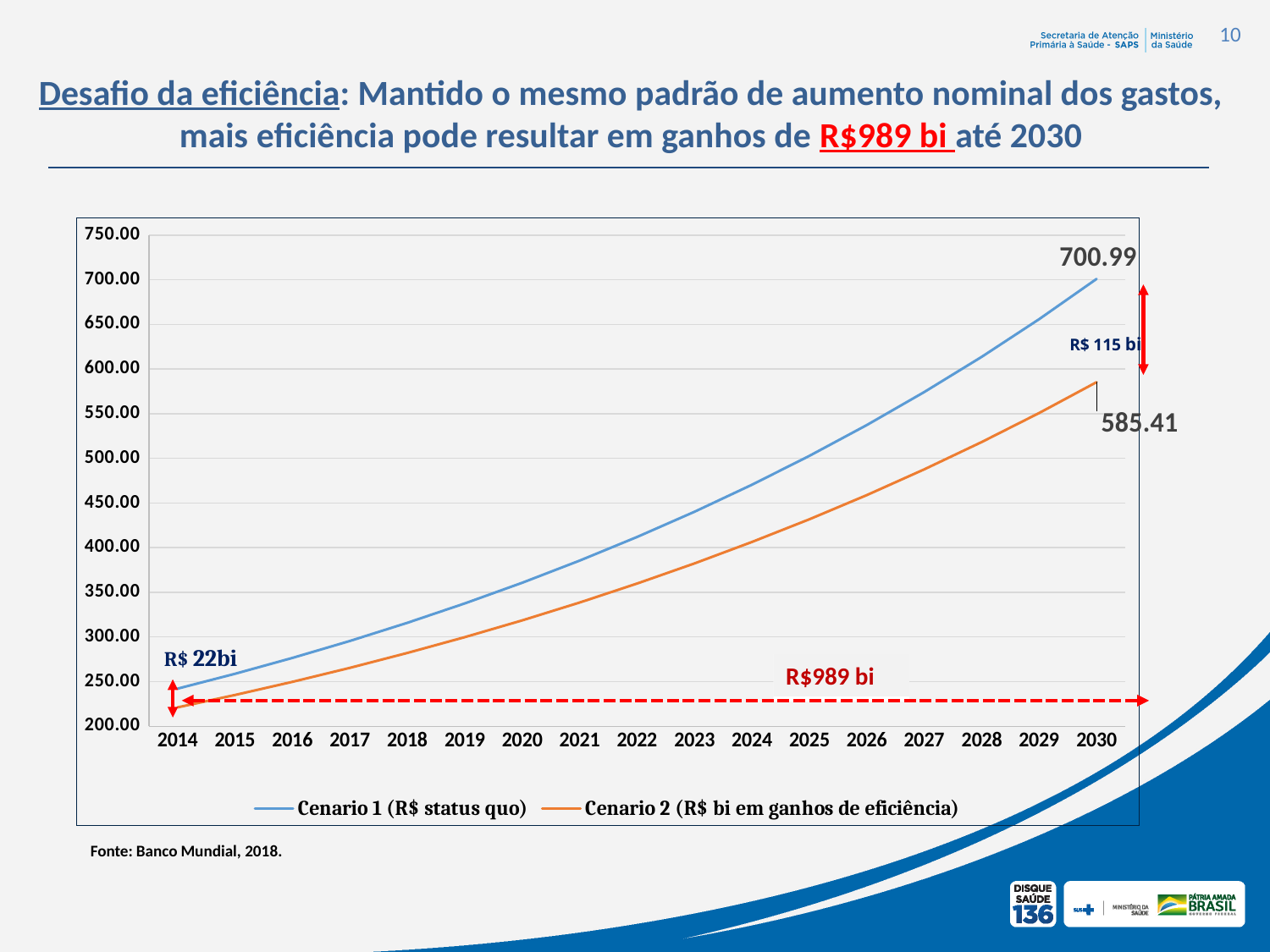
Is the value for Cenario 1 in 2025 greater or less than 450? greater What kind of chart is shown on the slide? Line chart What is the value of Cenario 2 (R$ bi em ganhos de eficiência) in 2030? 585.41 Do the values of Cenario 1 rise or fall from 2014 to 2030? Rise Is the value for Cenario 2 in 2020 greater or less than 350? less How many series does the legend list? 2 Is the value for Cenario 1 in 2014 greater or less than 300? less Which series has the higher value in 2030, Cenario 1 or Cenario 2? Cenario 1 What is the value of Cenario 1 (R$ status quo) in 2030? 700.99 How many years are shown on the x axis? 17 What is the difference between the 2030 values of Cenario 1 and Cenario 2? 115.58 What source is cited below the chart? Banco Mundial, 2018